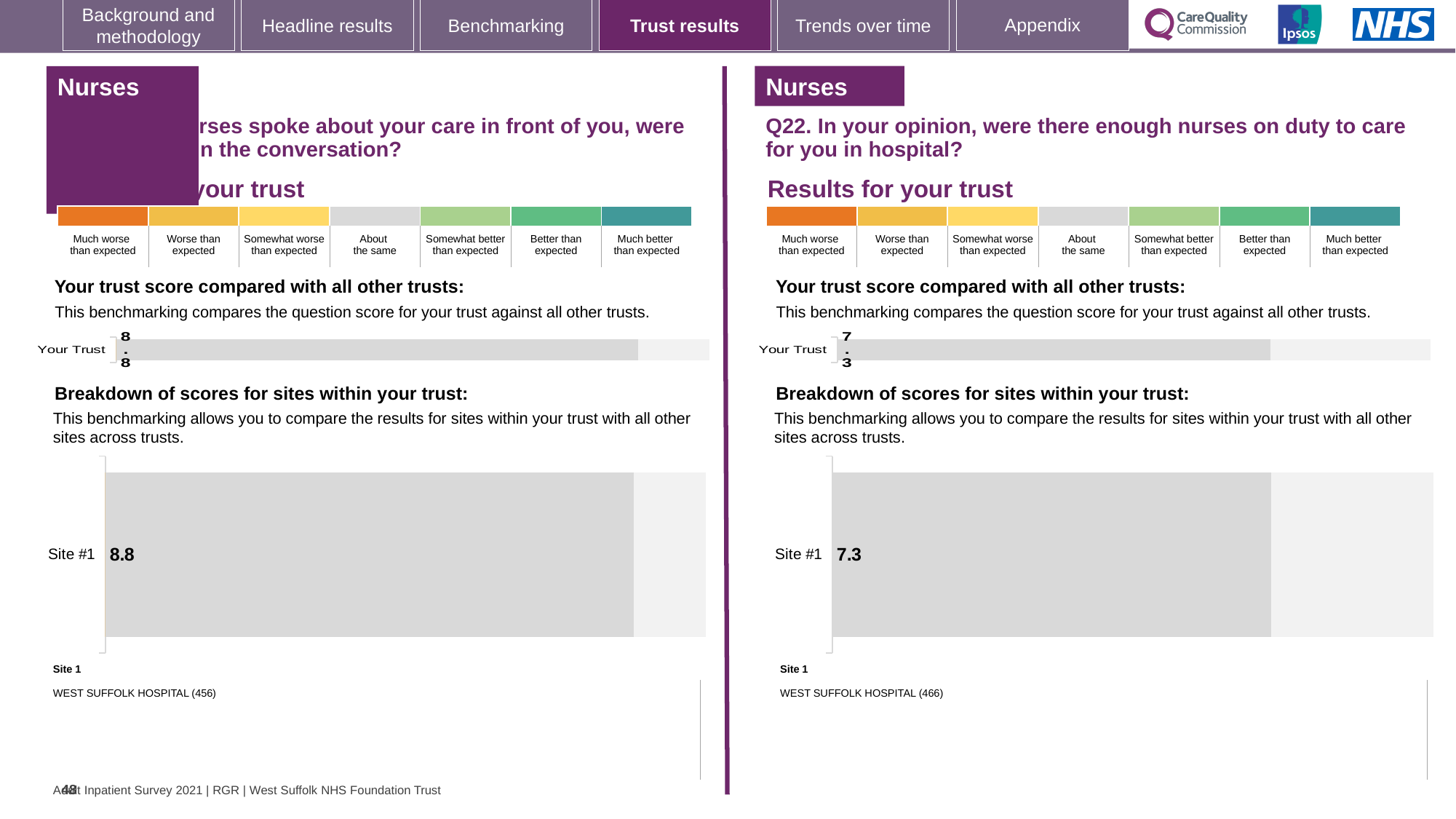
On the right half of the slide (Q22), what is the score shown for Site #1? 7.3 On the right half of the slide (Q22), which hospital is listed as Site 1? WEST SUFFOLK HOSPITAL (466) Which is larger: the Site #1 score on the left half of the slide or the Site #1 score on the right half (Q22)? Left half (8.8) What kind of chart is used to show the Site #1 score on the right half of the slide (Q22)? Bar chart On the right half of the slide (Q22), what is the score shown for Your Trust? 7.3 How many sites are shown in the site breakdown chart on the left half of the slide? 1 On the left half of the slide, what is the score shown for Your Trust? 8.8 On the left half of the slide, which hospital is listed as Site 1? WEST SUFFOLK HOSPITAL (456) What is the difference between the Site #1 score on the left half of the slide and the Site #1 score on the right half (Q22)? 1.5 How many sites are shown in the site breakdown chart on the right half of the slide (Q22)? 1 On the left half of the slide, what is the score shown for Site #1? 8.8